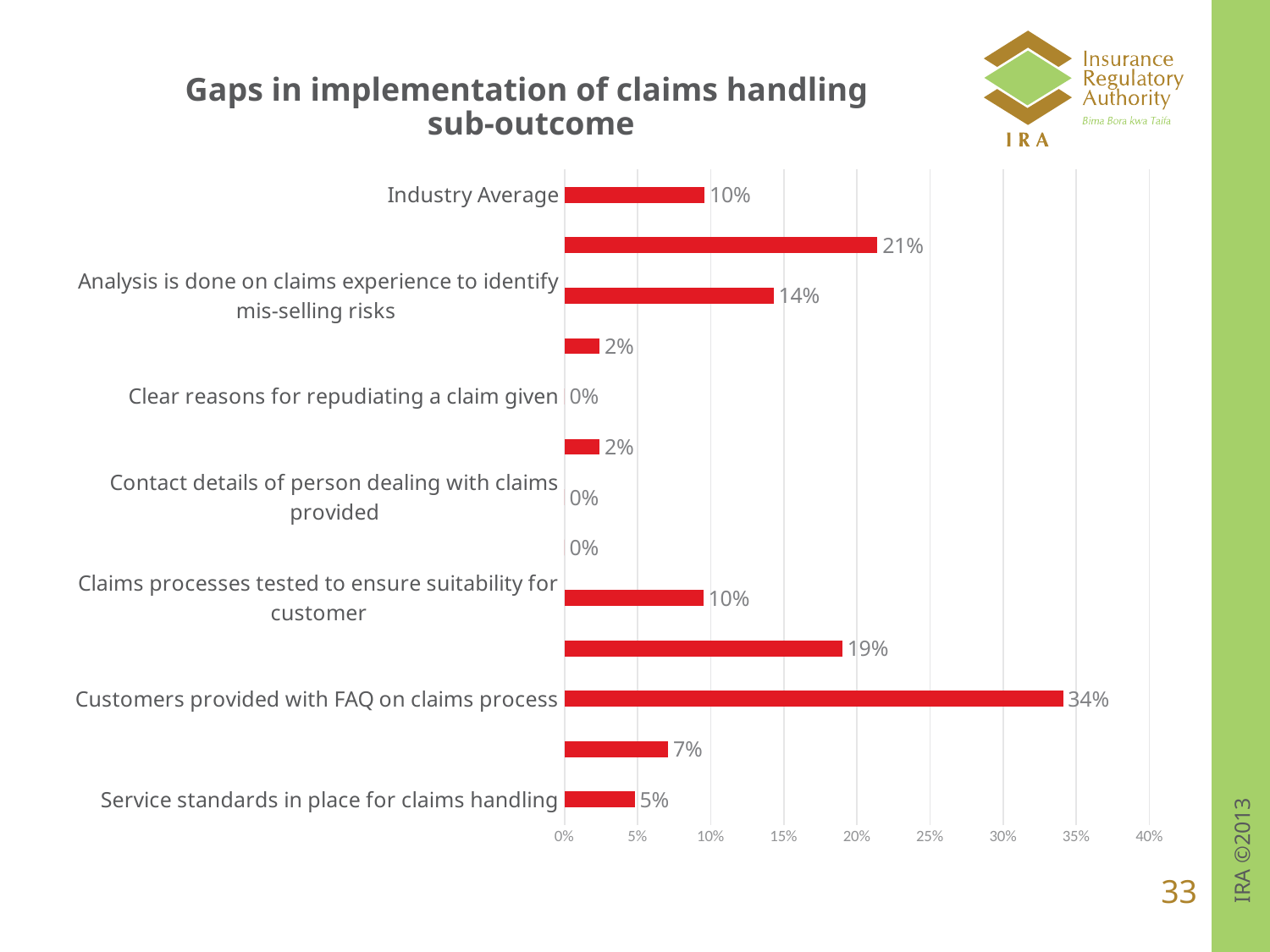
What is the value for 'Customers provided with FAQ on claims process'? 34% What type of chart is shown on the slide? Bar chart What is the value for 'Service standards in place for claims handling'? 5% What is the difference between the value for 'Customers provided with FAQ on claims process' and the Industry Average? 24% What is the value for 'Analysis is done on claims experience to identify mis-selling risks'? 14% Which is larger: the value for 'Analysis is done on claims experience to identify mis-selling risks' or the value for 'Service standards in place for claims handling'? Analysis is done on claims experience to identify mis-selling risks How many bars are plotted in the chart? 13 What is the value for 'Clear reasons for repudiating a claim given'? 0% Which category has the highest value in the chart? Customers provided with FAQ on claims process What is the value for Industry Average? 10% Is the value for 'Customers provided with FAQ on claims process' greater or less than 30%? greater What is the title of the slide? Gaps in implementation of claims handling sub-outcome